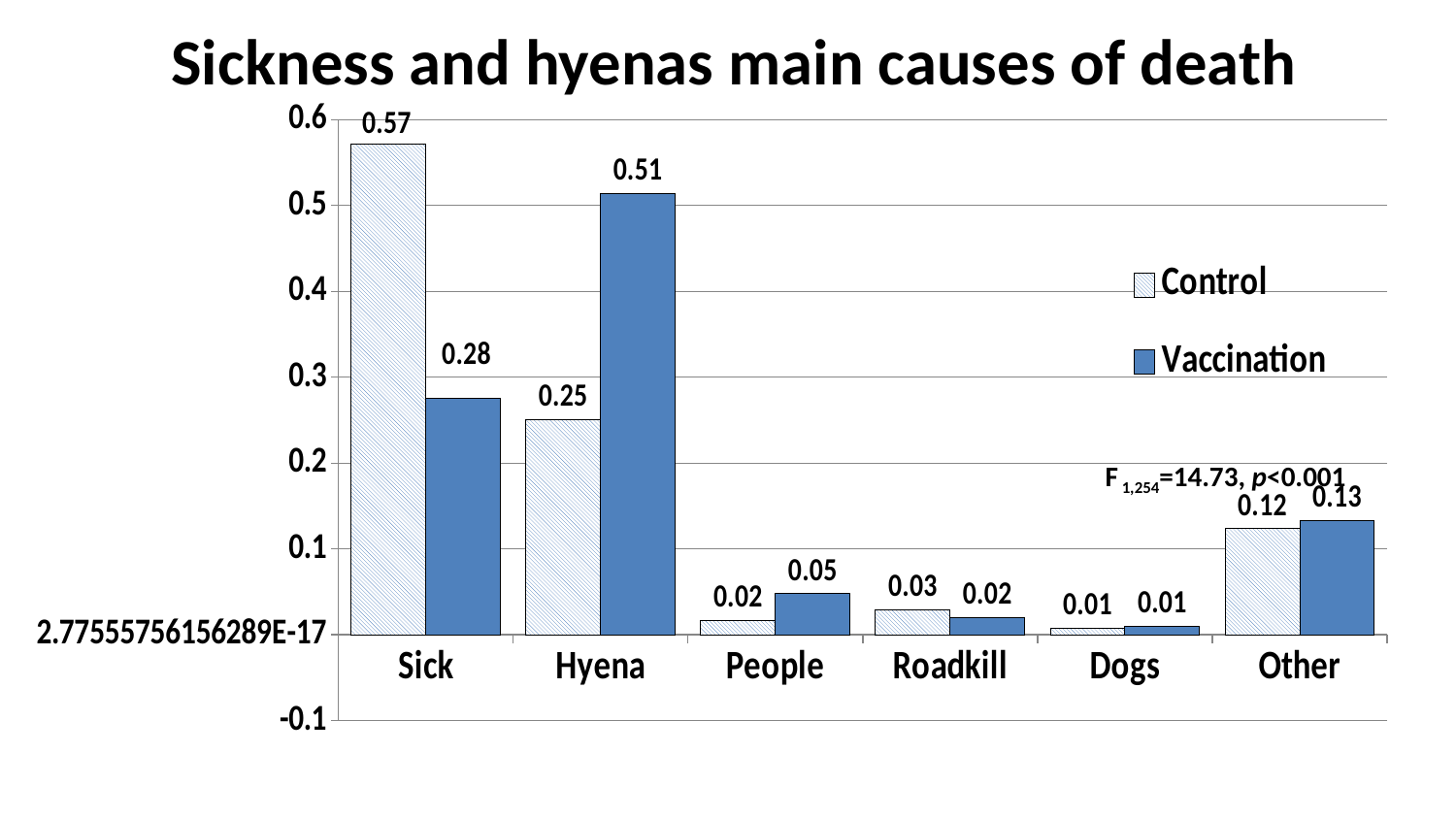
What is the difference between the Control and Vaccination values for Sick? 0.29 Which category has the lowest Vaccination value? Dogs What is the Vaccination value for People? 0.05 How many categories are shown on the x axis? 6 What is the Control value for Other? 0.12 Which is larger for Hyena, the Control value or the Vaccination value? Vaccination What is the Vaccination value for Hyena? 0.51 How many series does the legend list? 2 What kind of chart is shown on the slide? Bar chart Which category has the highest Control value? Sick What is the title of the chart? Sickness and hyenas main causes of death What is the Control value for Sick? 0.57